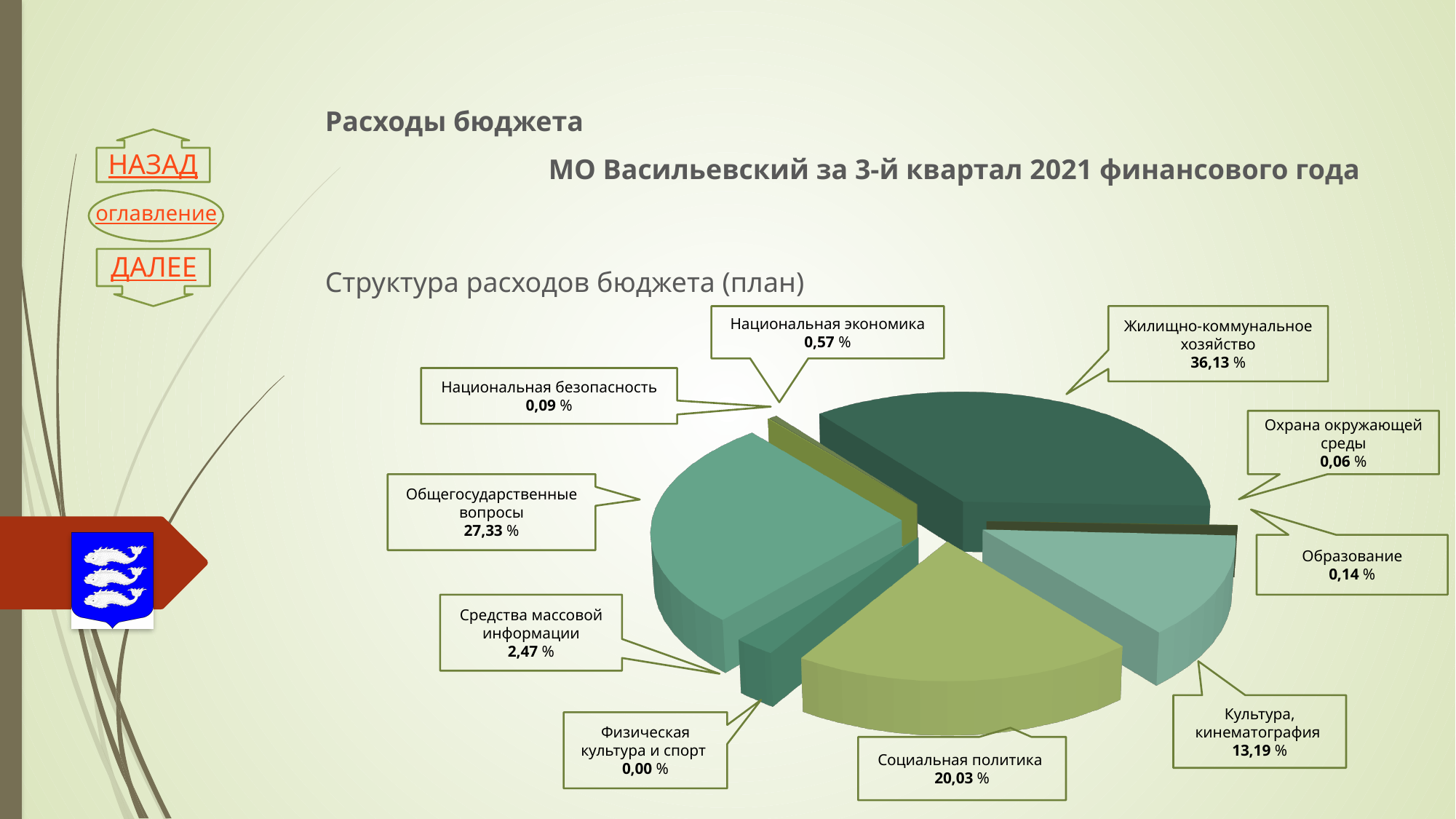
Which category has the largest share of the pie? Жилищно-коммунальное хозяйство How many categories are shown in the pie chart? 10 What is the value shown for Средства массовой информации? 2,47 % What is the difference between the shares of Социальная политика and Культура, кинематография? 6,84 % What share of the pie does Жилищно-коммунальное хозяйство account for? 36,13 % Which is larger: the share of Общегосударственные вопросы or the share of Социальная политика? Общегосударственные вопросы What kind of chart is shown on the slide? Pie chart What is the value shown for Охрана окружающей среды? 0,06 % What is the title of the chart? Структура расходов бюджета (план) What is the value shown for Социальная политика? 20,03 % What is the difference between the shares of Жилищно-коммунальное хозяйство and Общегосударственные вопросы? 8,80 % Which category has the smallest share of the pie? Физическая культура и спорт